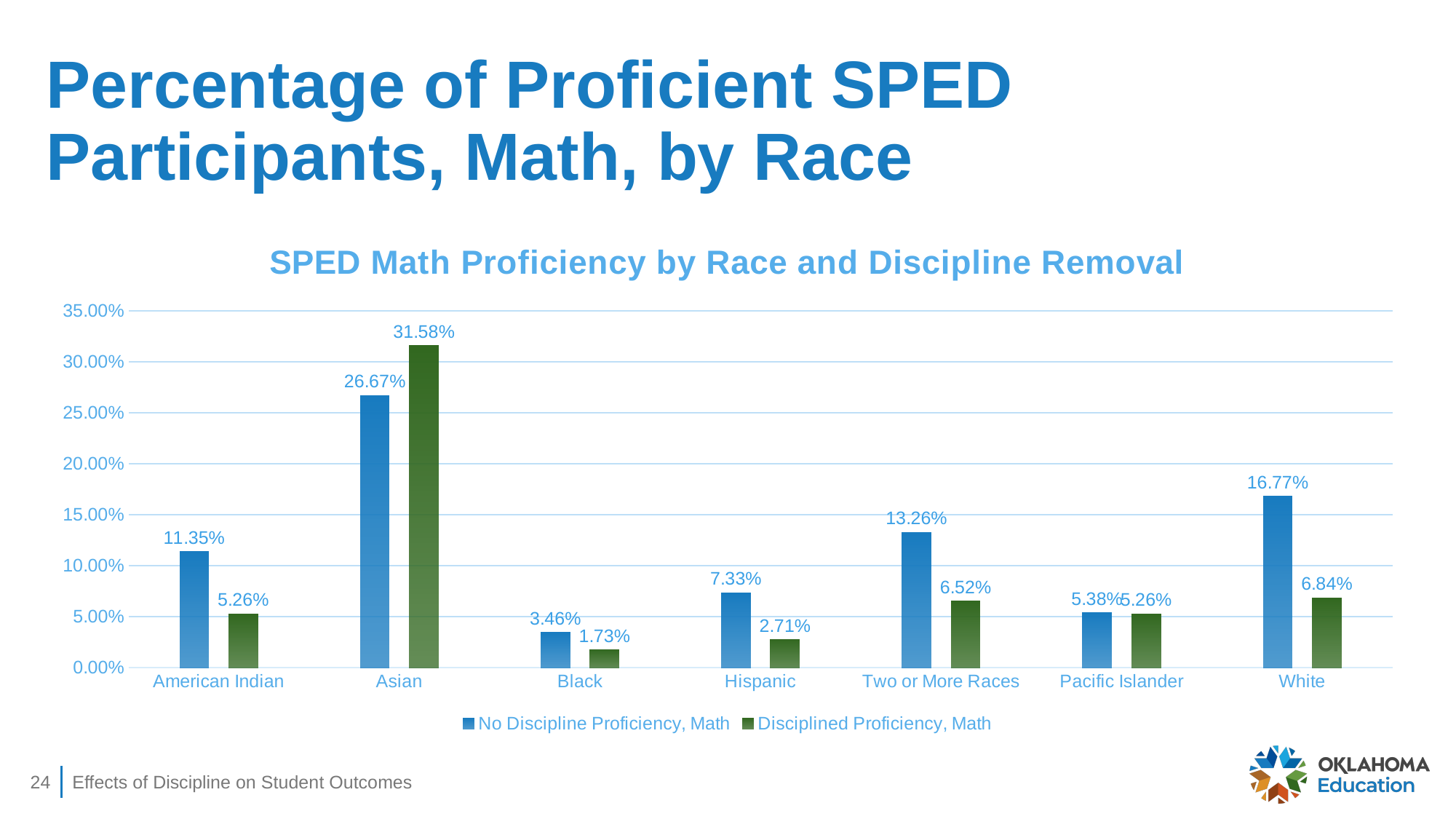
Which is larger for Hispanic: the No Discipline Proficiency, Math value or the Disciplined Proficiency, Math value? No Discipline Proficiency, Math Which race has the lowest No Discipline Proficiency, Math value? Black How many series does the legend list? 2 What kind of chart is shown on the slide? Bar chart Is the No Discipline Proficiency, Math value for White greater or less than 15.00%? greater What is the difference between the No Discipline and Disciplined Proficiency, Math values for American Indian? 6.09% What is the No Discipline Proficiency, Math value for Asian? 26.67% Which race has the highest Disciplined Proficiency, Math value? Asian What is the Disciplined Proficiency, Math value for White? 6.84% How many race categories are shown on the x axis? 7 What is the No Discipline Proficiency, Math value for Two or More Races? 13.26% What is the title of the chart? SPED Math Proficiency by Race and Discipline Removal